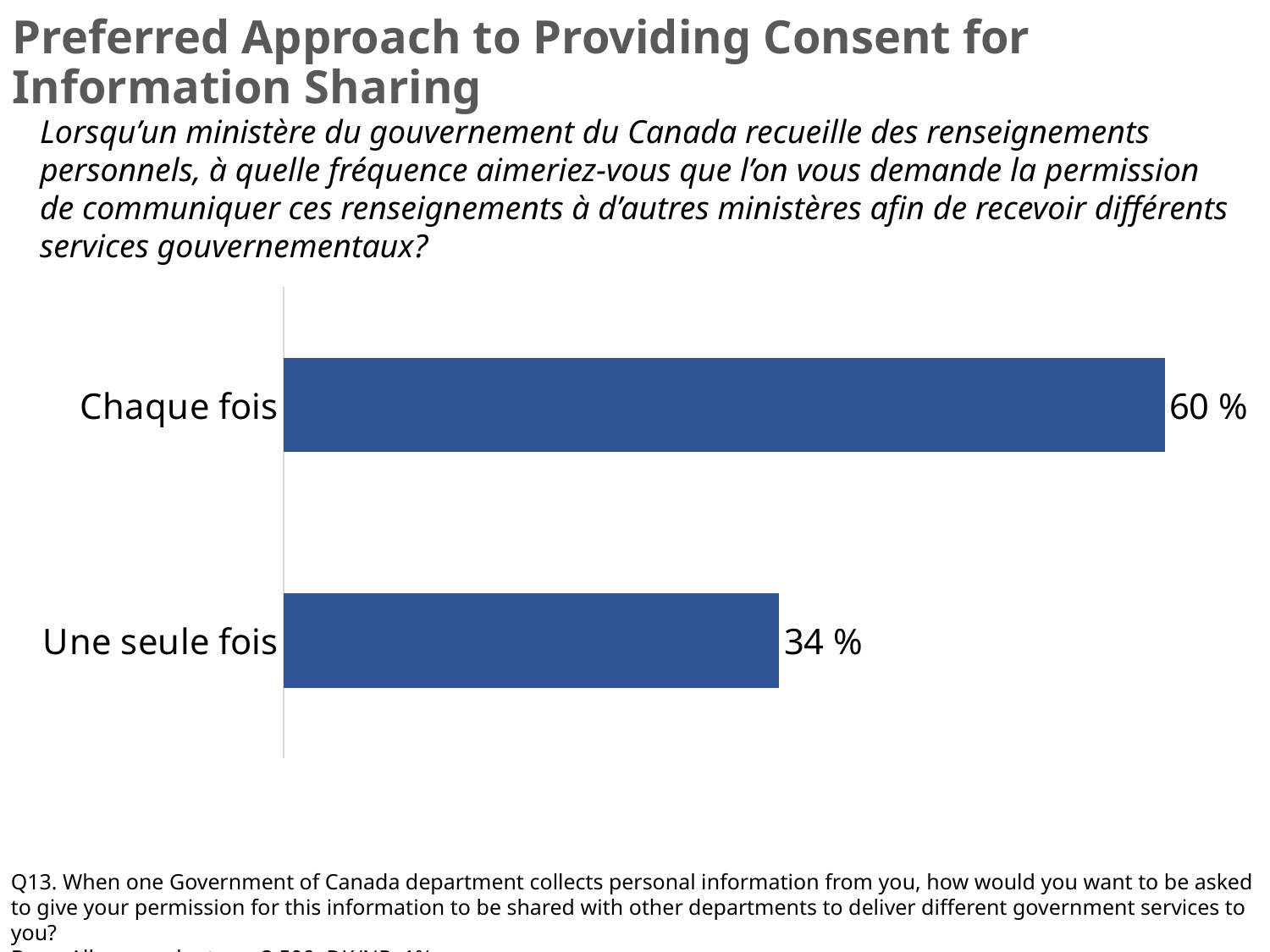
What colour are the bars in the chart? Blue Which category has the lowest value? Une seule fois What is the value for "Chaque fois"? 60 % What kind of chart is shown on the slide? Bar chart How many categories are shown in the chart? 2 What is the value for "Une seule fois"? 34 % Are the bars in the chart horizontal or vertical? Horizontal Which category has the highest value? Chaque fois Which is larger, the value for "Chaque fois" or the value for "Une seule fois"? Chaque fois What is the difference between the values for "Chaque fois" and "Une seule fois"? 26 %